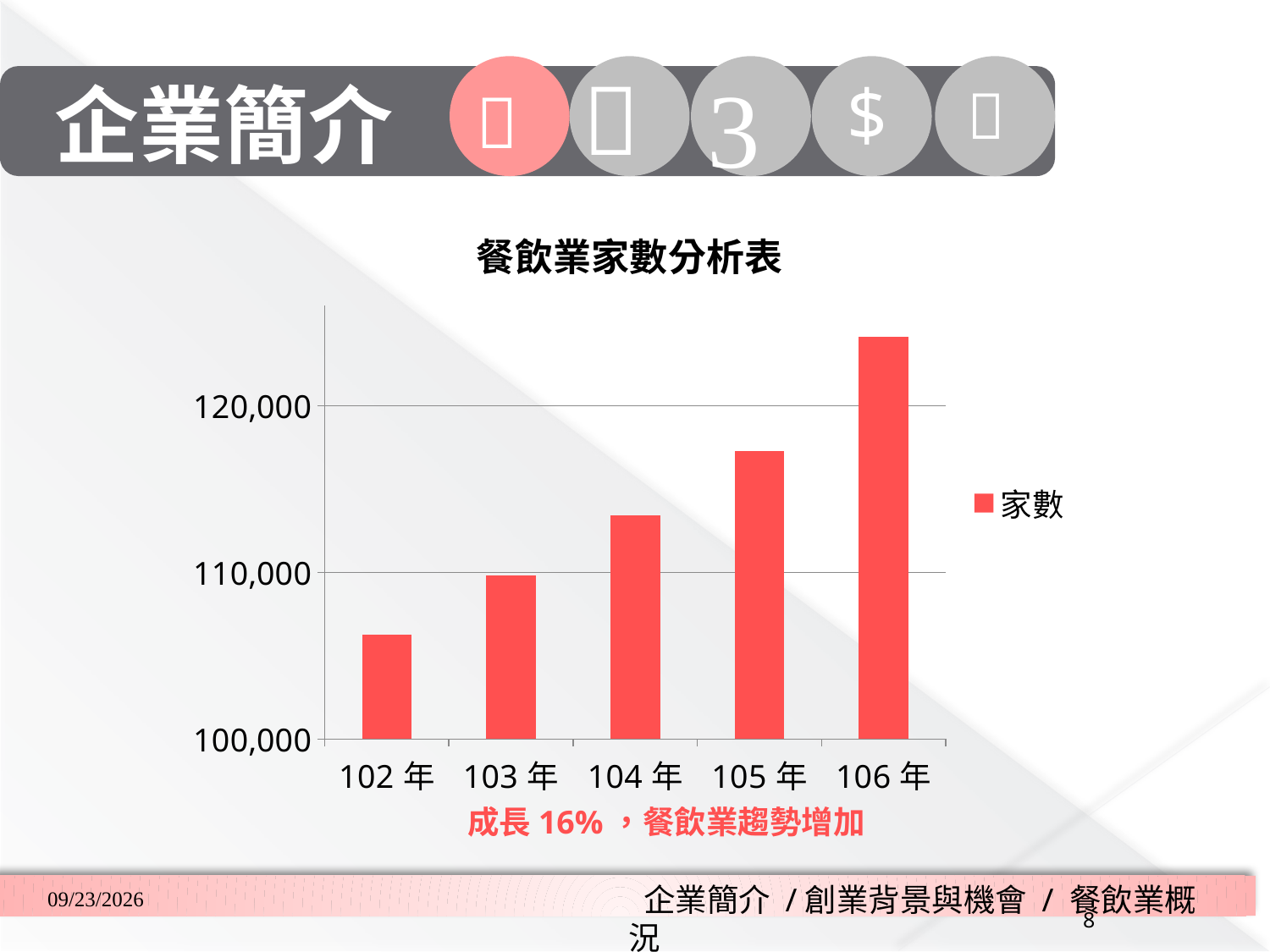
Which is larger, the value for 105 年 or the value for 103 年? 105 年 How many series does the legend list? 1 Is the value for 104 年 greater or less than 110,000? greater Is the value for 102 年 greater or less than 110,000? less Which year has the lowest value? 102 年 What is the title of the chart? 餐飲業家數分析表 Do the values rise or fall from 102 年 to 106 年? rise How many categories are shown on the x axis? 5 What kind of chart is shown on the slide? bar chart Which year has the highest value? 106 年 What is the name of the series shown in the legend? 家數 Is the value for 106 年 greater or less than 120,000? greater